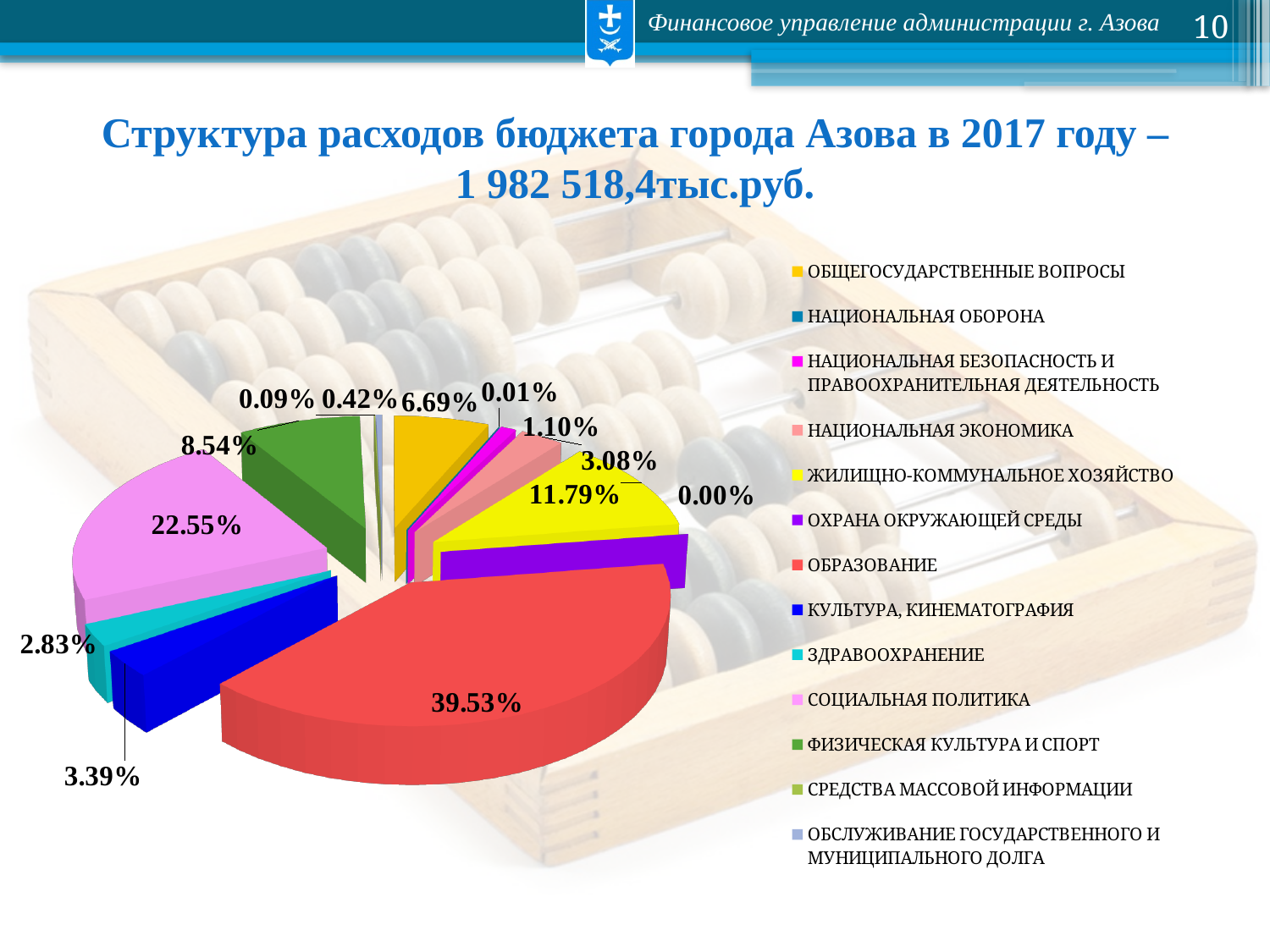
What share of expenditure is shown for ОБЩЕГОСУДАРСТВЕННЫЕ ВОПРОСЫ? 6.69% By how many percentage points does the share for ОБРАЗОВАНИЕ exceed the share for СОЦИАЛЬНАЯ ПОЛИТИКА? 16.98 percentage points What share of expenditure is shown for КУЛЬТУРА, КИНЕМАТОГРАФИЯ? 3.39% What share of expenditure is shown for ФИЗИЧЕСКАЯ КУЛЬТУРА И СПОРТ? 8.54% How many expenditure categories does the legend list? 13 What total budget expenditure amount is stated in the chart title? 1 982 518,4 тыс.руб. What share of expenditure is shown for ЖИЛИЩНО-КОММУНАЛЬНОЕ ХОЗЯЙСТВО? 11.79% Which expenditure category has the largest share of the pie? ОБРАЗОВАНИЕ What share of the 2017 Azov budget expenditure goes to ОБРАЗОВАНИЕ? 39.53% What kind of chart is shown on the slide? Pie chart Which is larger: the share for ОБРАЗОВАНИЕ or the share for СОЦИАЛЬНАЯ ПОЛИТИКА? ОБРАЗОВАНИЕ What share of expenditure is shown for СОЦИАЛЬНАЯ ПОЛИТИКА? 22.55%